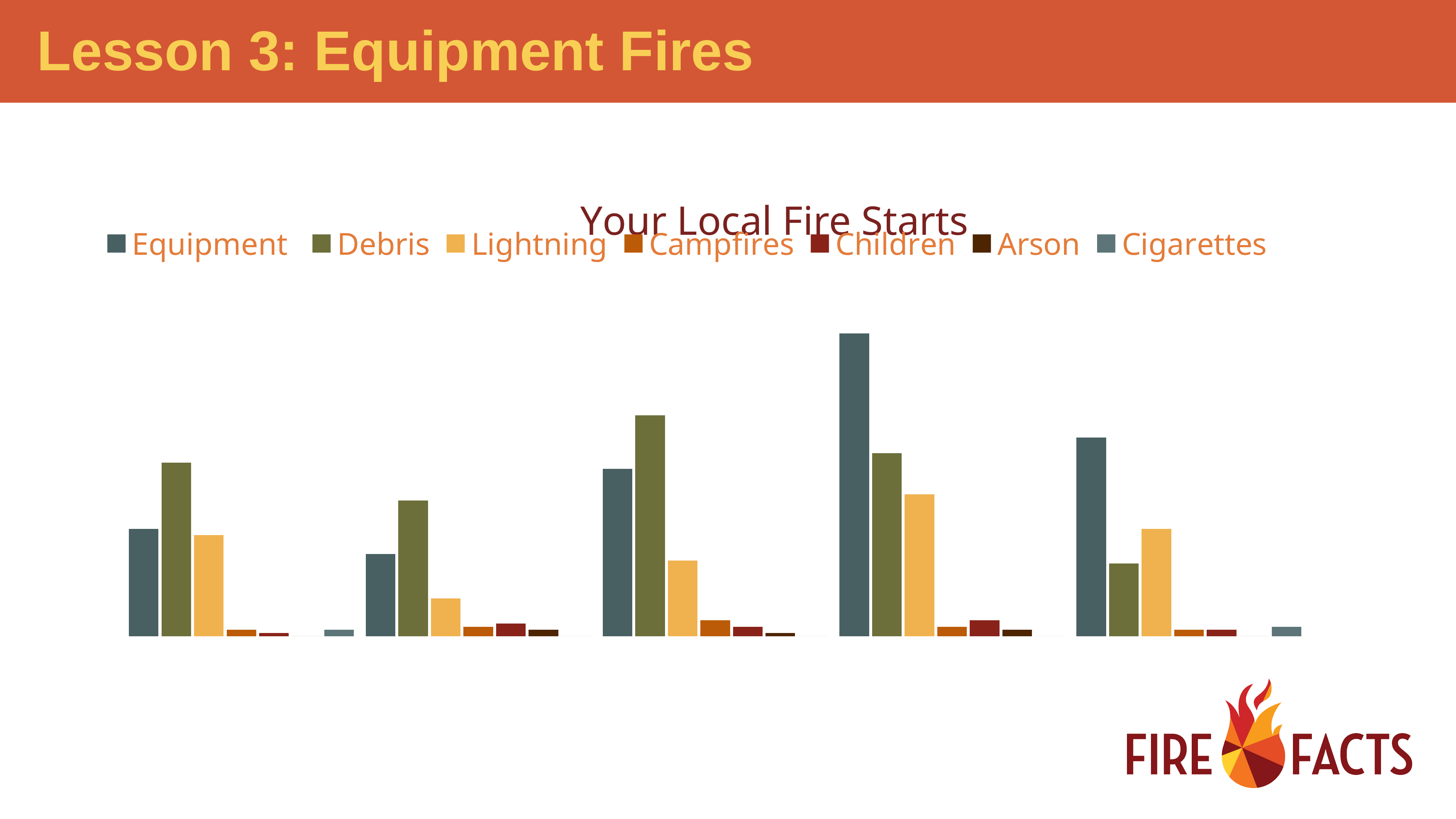
In the fifth group of bars from the left, which is larger: Debris or Lightning? Lightning Which series has the tallest bar in the first group of bars from the left? Debris What kind of chart is shown on the slide? bar chart Which series has the tallest bar in the fifth group of bars from the left? Equipment What is the title of the chart? Your Local Fire Starts Do the Equipment bars rise or fall from the first group to the fourth group along the x axis? rise How many groups of bars are plotted along the x axis? 5 In the second group of bars from the left, which is larger: Equipment or Debris? Debris Which series has the tallest bar in the third group of bars from the left? Debris Which series is shown in the legend immediately after Lightning? Campfires How many series does the chart's legend list? 7